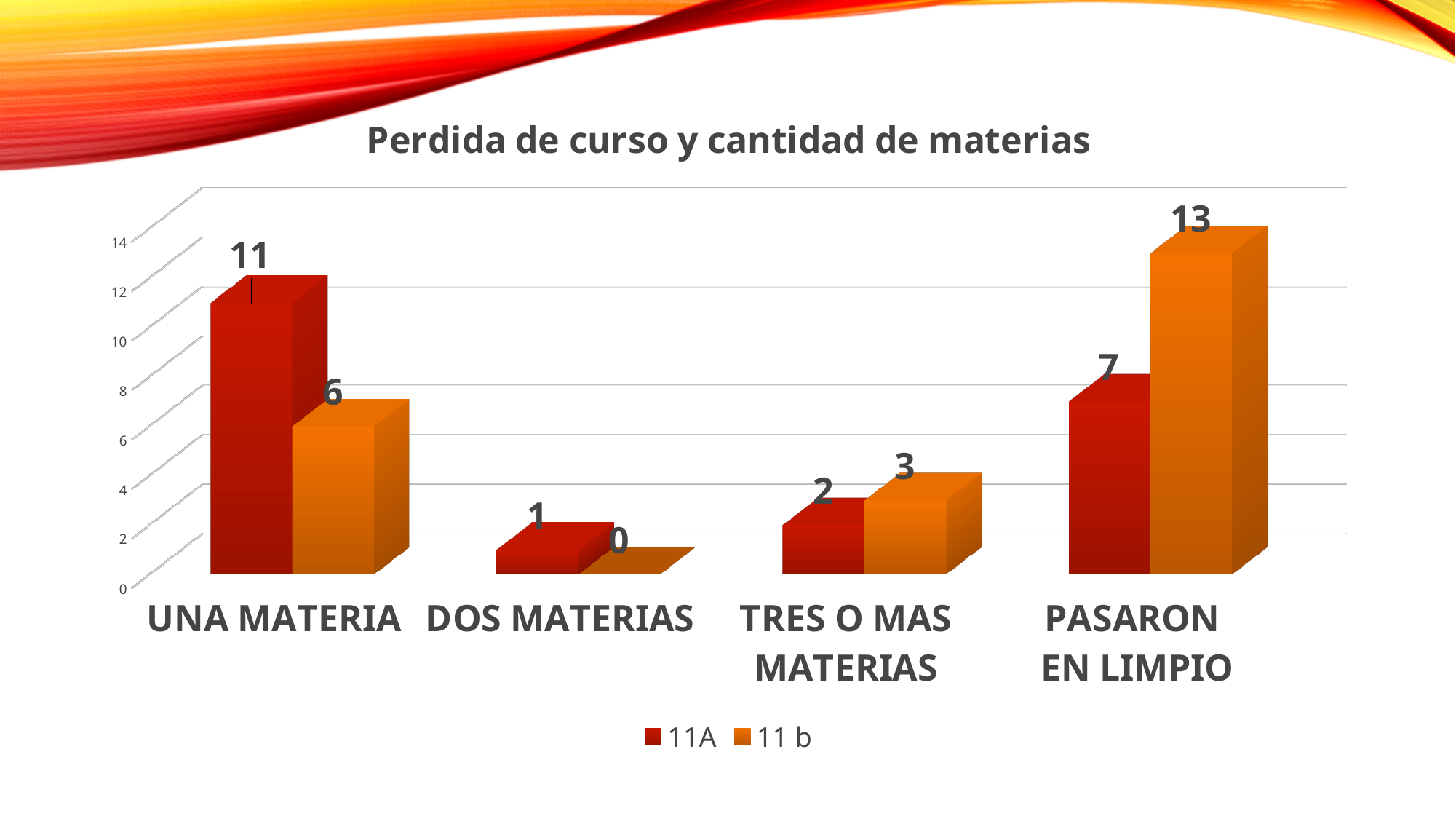
What is the difference between the 11 b and 11A values in the PASARON EN LIMPIO category? 6 Which category has the highest value for the 11 b series? PASARON EN LIMPIO How many categories are shown on the x axis? 4 How many series does the legend list? 2 What kind of chart is shown on the slide? Bar chart Which category has the lowest value for the 11A series? DOS MATERIAS What is the value for 11A in the UNA MATERIA category? 11 What is the value for 11A in the TRES O MAS MATERIAS category? 2 In the UNA MATERIA category, which series has the larger value, 11A or 11 b? 11A What is the value for 11 b in the PASARON EN LIMPIO category? 13 What is the value for 11 b in the DOS MATERIAS category? 0 What is the title of the chart? Perdida de curso y cantidad de materias